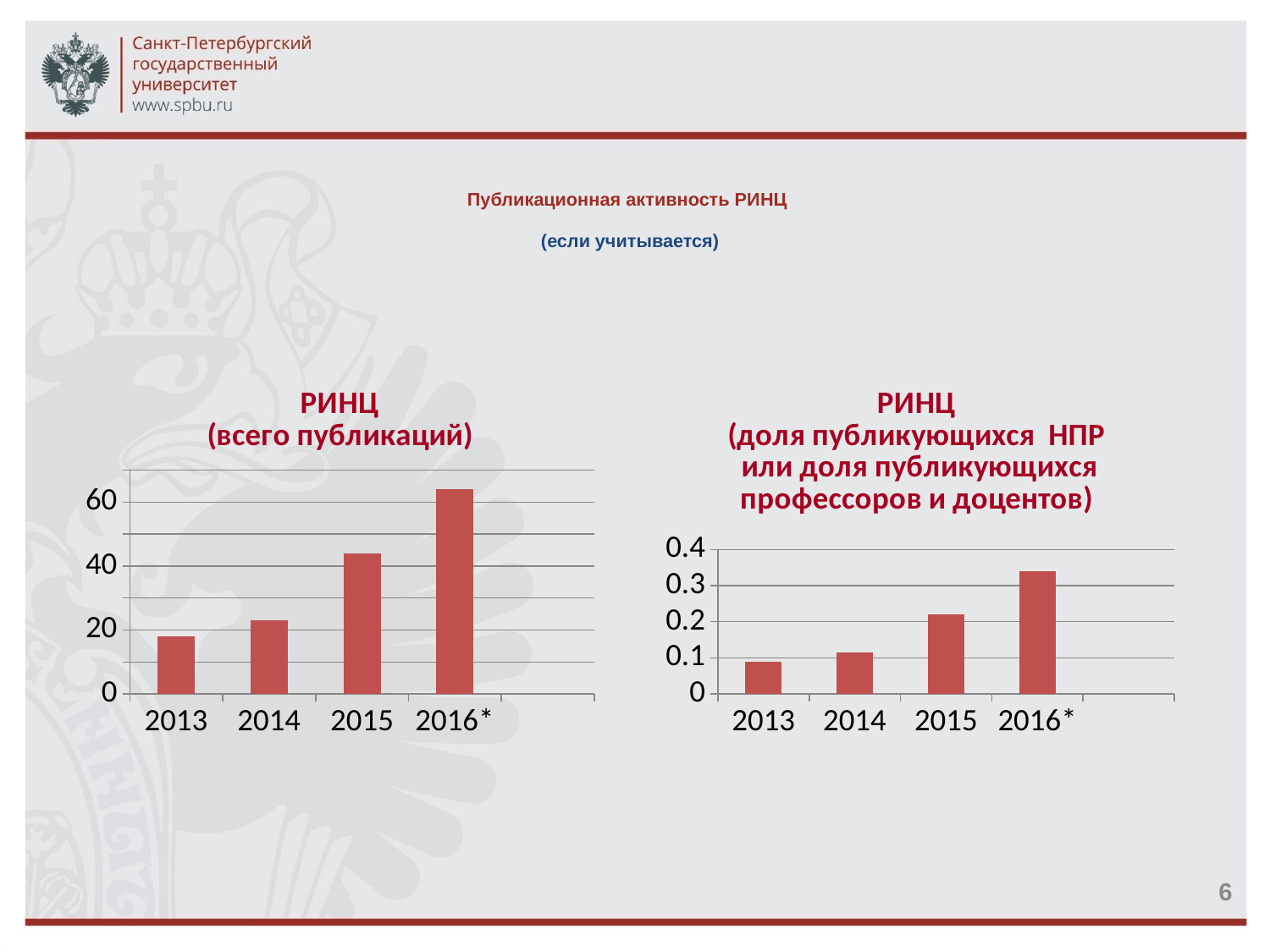
In the left chart (РИНЦ, всего публикаций), is the value for 2015 greater or less than 40? greater In the left chart (РИНЦ, всего публикаций), which year has the lowest value? 2013 In the right chart (РИНЦ, доля публикующихся НПР), which is larger, the value for 2014 or the value for 2015? 2015 In the left chart (РИНЦ, всего публикаций), is the value for 2016* greater or less than 60? greater In the right chart (РИНЦ, доля публикующихся НПР), is the value for 2016* greater or less than 0.3? greater In the left chart (РИНЦ, всего публикаций), how many years are shown on the x axis? 4 In the left chart (РИНЦ, всего публикаций), do the values rise or fall from 2013 to 2016*? rise In the left chart (РИНЦ, всего публикаций), which year has the highest value? 2016* What type of chart is the right chart (РИНЦ, доля публикующихся НПР)? bar chart In the right chart (РИНЦ, доля публикующихся НПР), which year has the highest value? 2016*